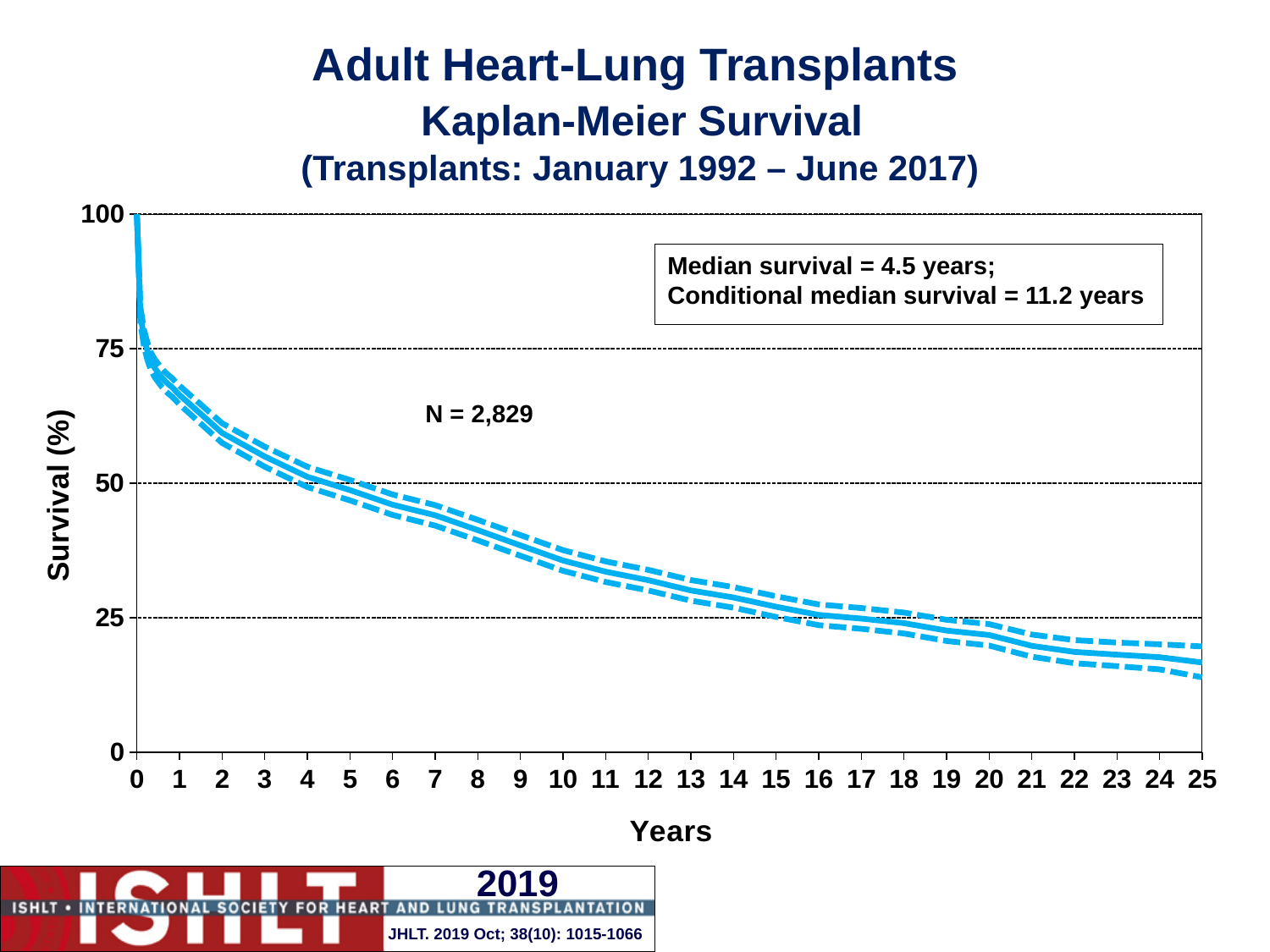
Is the survival value at 10 years greater or less than 50? less What is the value of N shown on the chart? 2,829 What kind of chart is shown on the slide? Line chart Is the survival value at 20 years greater or less than 25? less Does survival rise or fall as years increase along the x axis? Fall Is the survival value at 1 year greater or less than 50? greater What is the label of the y axis? Survival (%) What is the conditional median survival stated on the chart? 11.2 years What transplant date range is given in the chart title? January 1992 – June 2017 What is the median survival stated on the chart? 4.5 years